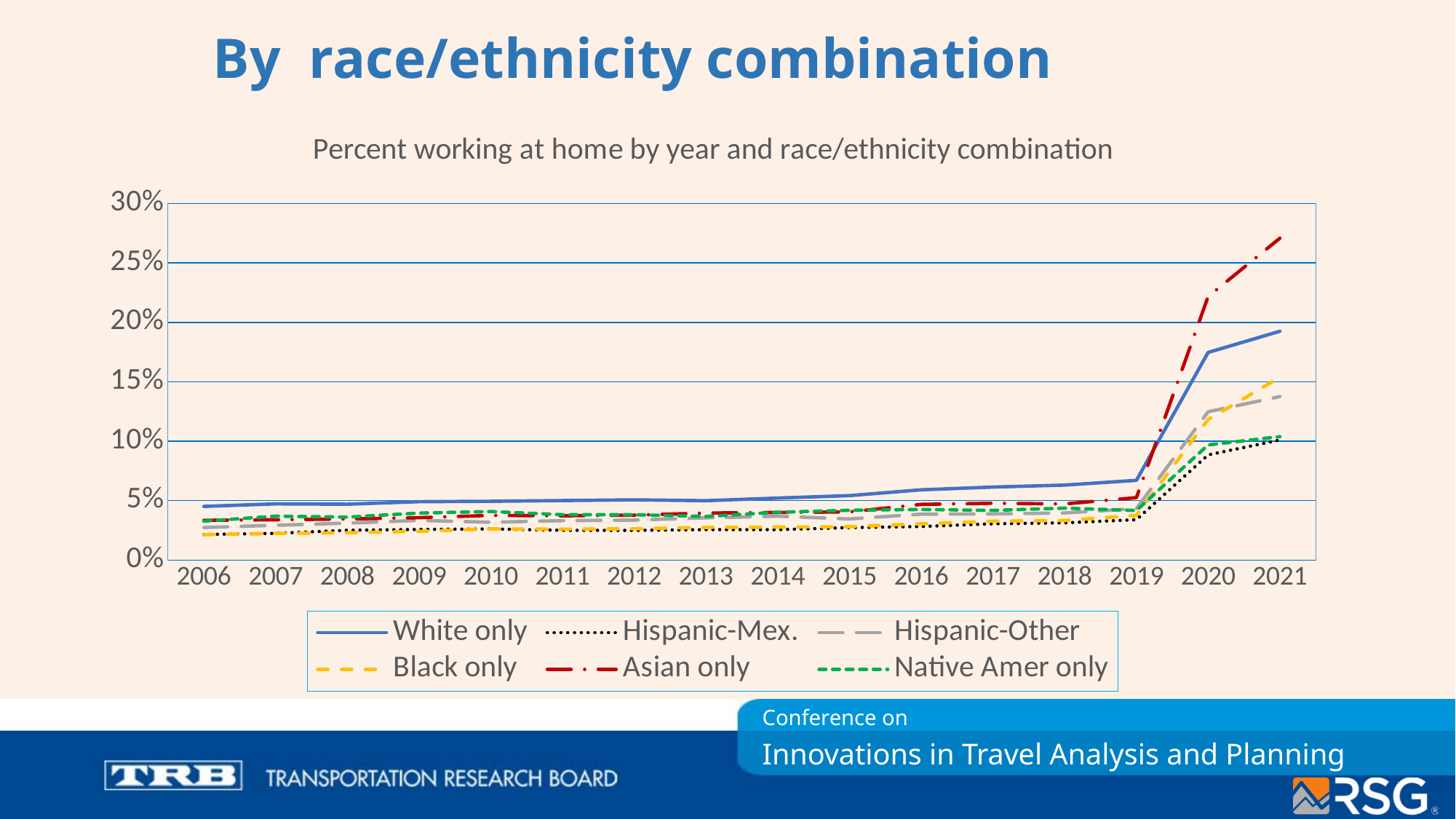
Does the White only series rise or fall from 2006 to 2021? rise Is the value for Asian only in 2021 greater or less than 25%? greater Which series has the highest value in 2021? Asian only Which series has the highest value in 2006? White only Is the value for Black only in 2021 greater or less than 20%? less In 2021, which is larger: the value for White only or the value for Black only? White only How many years are shown on the x axis? 16 Is the value for White only in 2021 greater or less than 15%? greater What kind of chart is shown on the slide? line chart What is the title of the chart? Percent working at home by year and race/ethnicity combination How many series does the legend list? 6